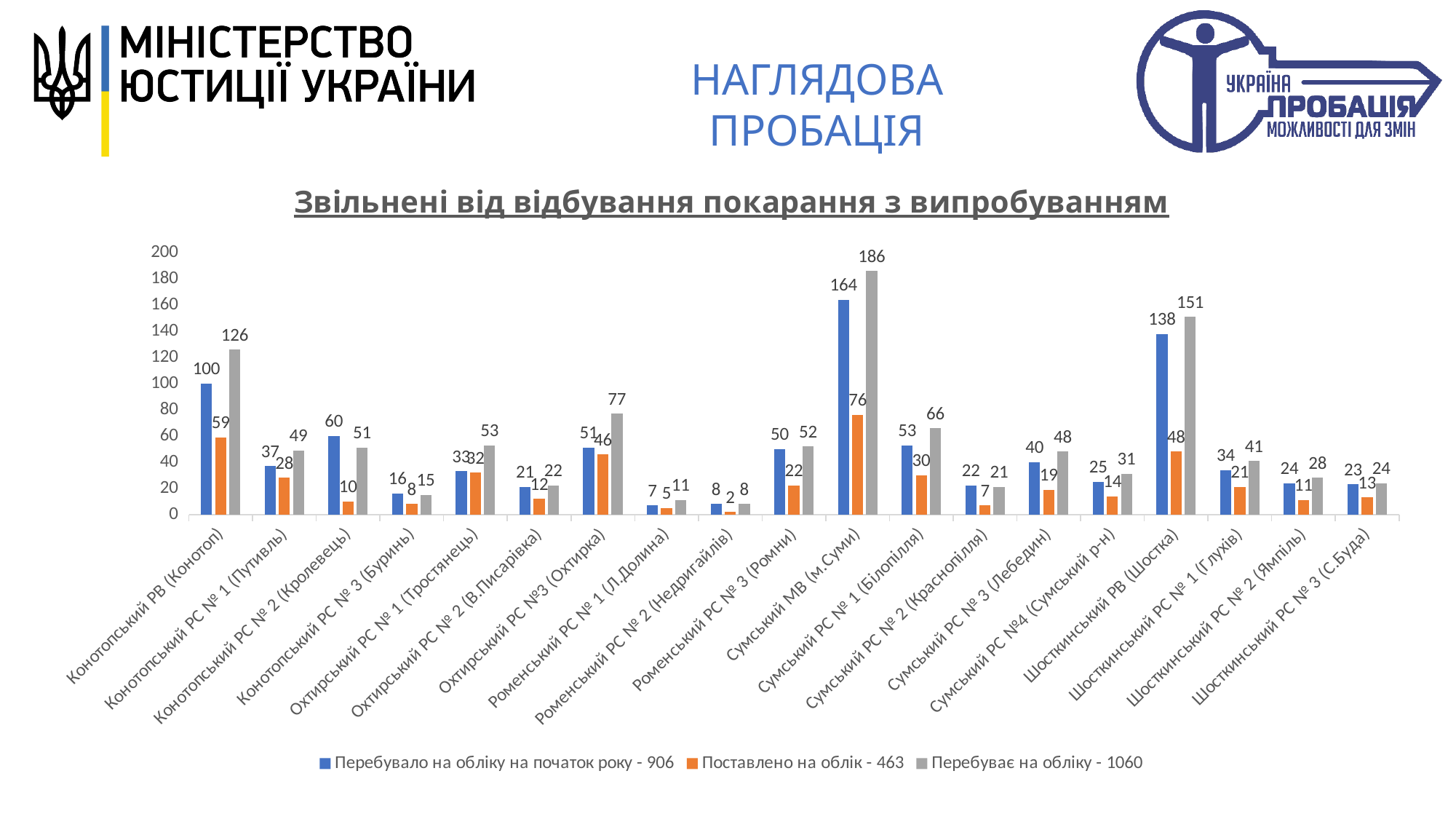
Which category has the lowest value for 'Поставлено на облік'? Роменський РС № 2 (Недригайлів) What is the value of 'Перебуває на обліку' for Сумський МВ (м.Суми)? 186 What type of chart is shown on the slide? Bar chart What total is shown in the legend for the series 'Перебуває на обліку'? 1060 What is the difference between 'Перебуває на обліку' and 'Перебувало на обліку на початок року' for Охтирський РС №3 (Охтирка)? 26 How many series does the legend list? 3 How many categories (units) are shown on the x axis? 19 Which category has the highest value for 'Перебуває на обліку'? Сумський МВ (м.Суми) Which is larger for Конотопський РС № 2 (Кролевець): 'Перебувало на обліку на початок року' or 'Перебуває на обліку'? Перебувало на обліку на початок року What is the value of 'Перебувало на обліку на початок року' for Шосткинський РВ (Шостка)? 138 What is the value of 'Поставлено на облік' for Конотопський РВ (Конотоп)? 59 Is the value of 'Перебуває на обліку' for Шосткинський РВ (Шостка) greater or less than 140? greater